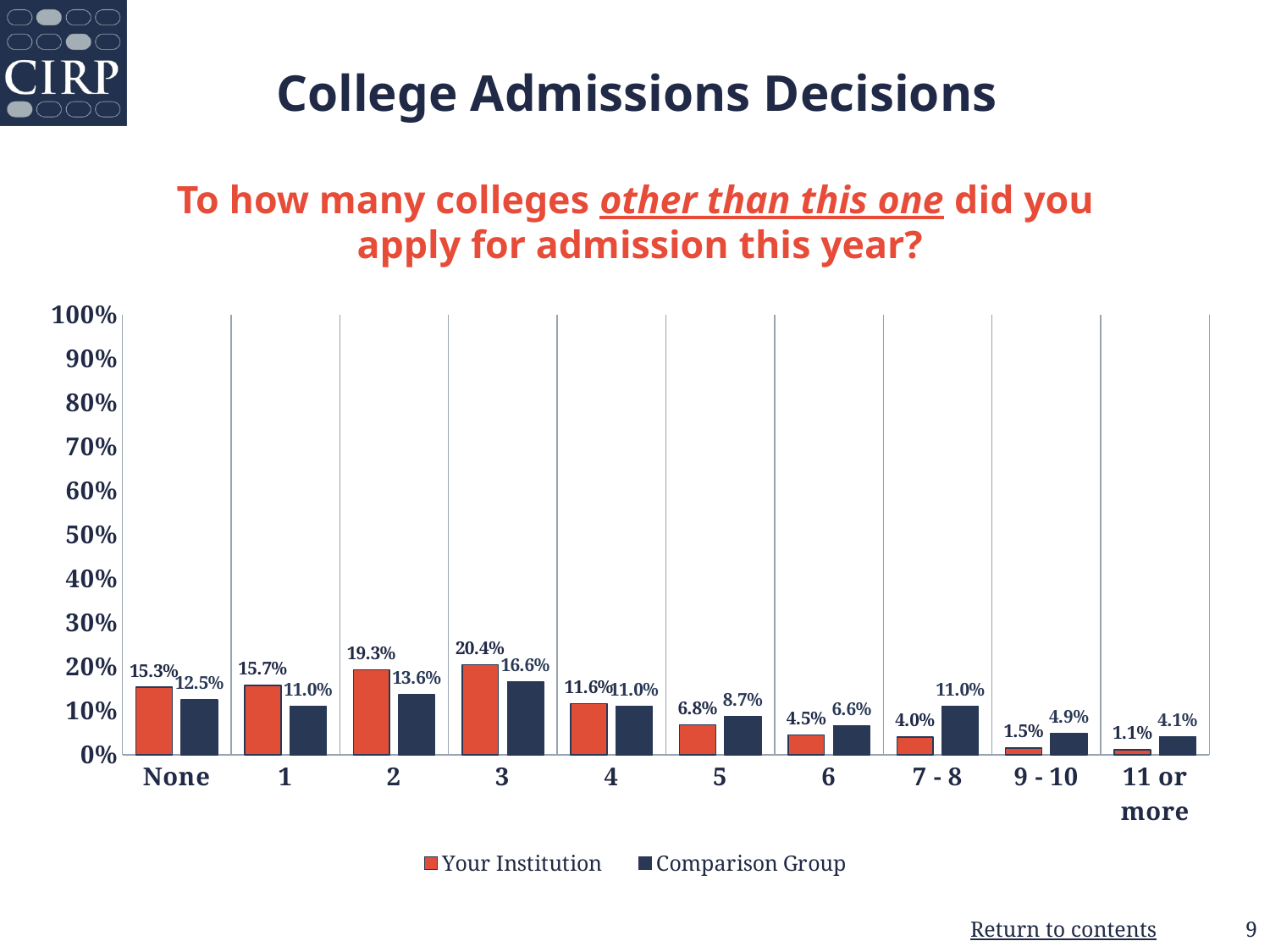
Which category has the highest value for Your Institution? 3 What is the value for Your Institution in the "3" category? 20.4% How many series does the legend list? 2 Is the value for Your Institution in the "2" category greater or less than 10%? greater How many categories are shown on the x axis? 10 What is the value for Comparison Group in the "7 - 8" category? 11.0% What is the value for Comparison Group in the "None" category? 12.5% What colour are the bars for Your Institution? orange-red What kind of chart is shown on the slide? bar chart What is the difference between Your Institution and Comparison Group in the "7 - 8" category? 7.0% Which category has the lowest value for Comparison Group? 11 or more Which is larger in the "5" category: Your Institution or Comparison Group? Comparison Group